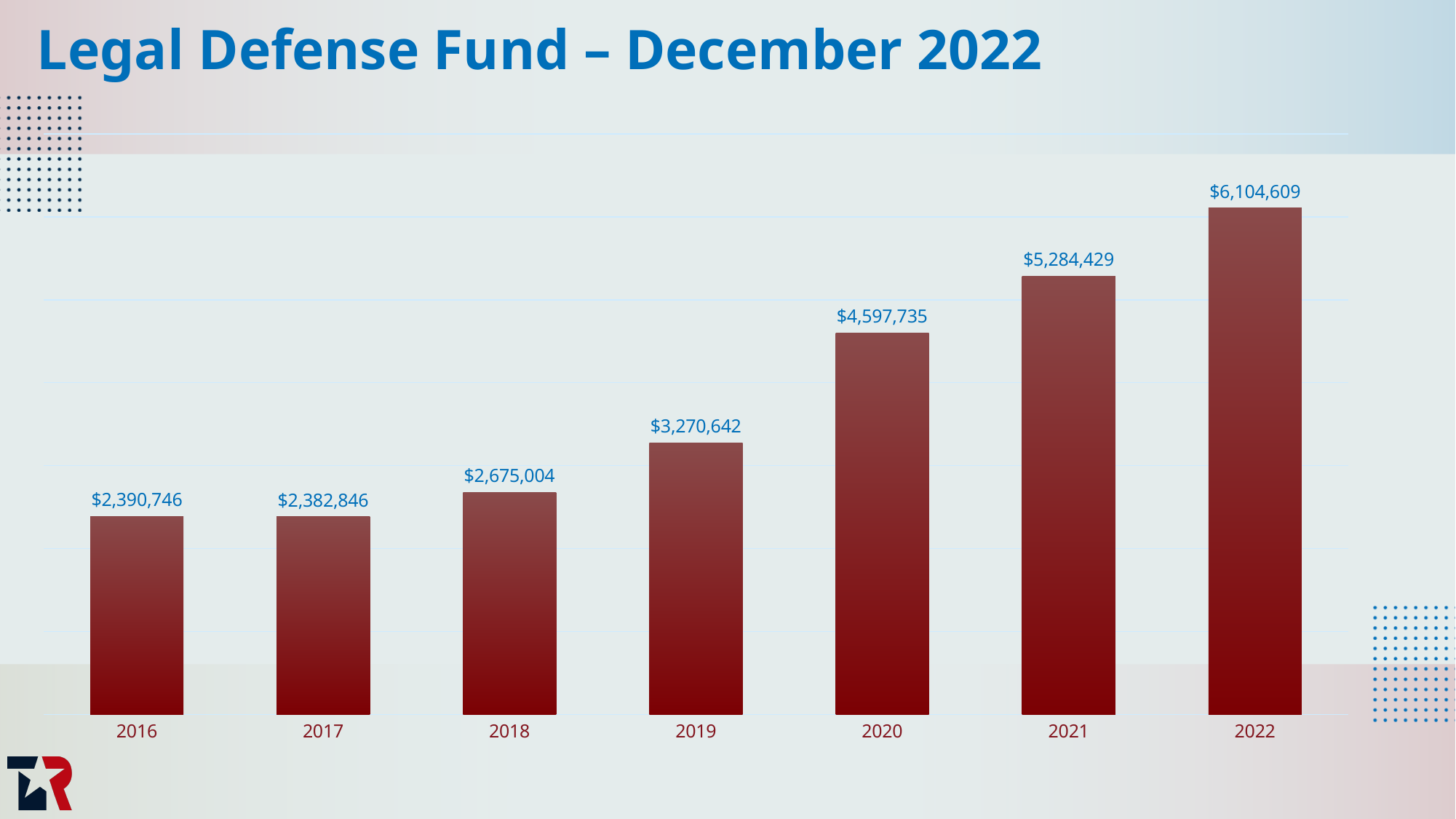
What is the value for 2022? $6,104,609 What is the value for 2019? $3,270,642 What is the value for 2017? $2,382,846 What is the title of the slide? Legal Defense Fund – December 2022 Which year has the highest value? 2022 Which is larger, the value for 2018 or the value for 2019? 2019 What is the difference between the values for 2020 and 2019? $1,327,093 What is the difference between the values for 2022 and 2021? $820,180 How many years are shown on the chart? 7 Which year has the lowest value? 2017 Do the values generally rise or fall from 2017 to 2022? Rise What kind of chart is shown on the slide? Bar chart